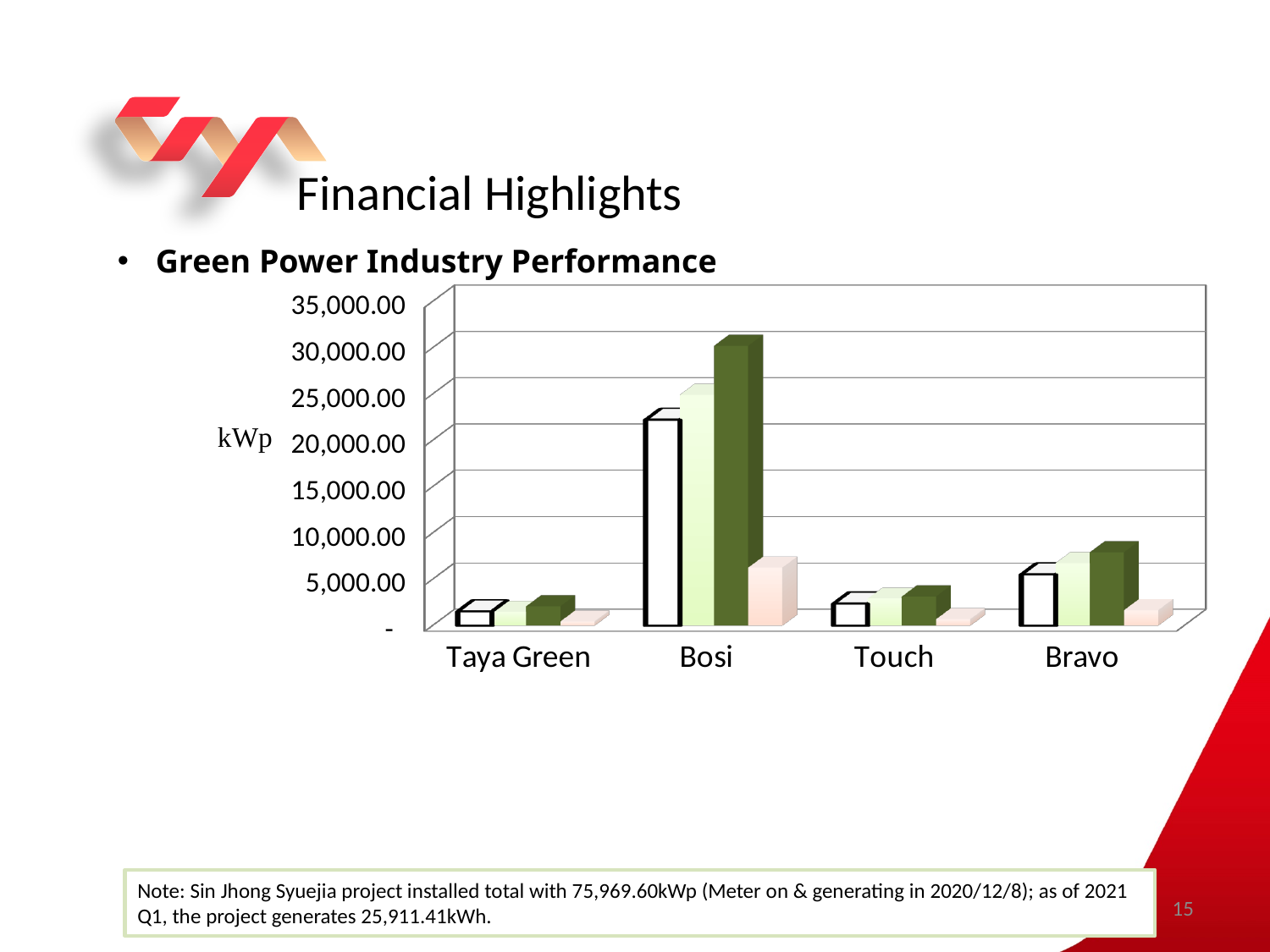
What unit is shown as the label of the vertical axis? kWp How many categories are shown on the x axis of the chart? 4 Is the tallest bar for Bravo greater or less than 10,000? less Is the tallest bar for Touch greater or less than 5,000? less Which category has taller bars, Bravo or Touch? Bravo Is the tallest bar for Taya Green greater or less than 5,000? less What kind of chart is shown on the slide? bar chart Which category has the tallest bar in the chart? Bosi Which category has taller bars, Bosi or Bravo? Bosi What is the highest value shown on the vertical axis of the chart? 35,000.00 How many bars are plotted for each category in the chart? 4